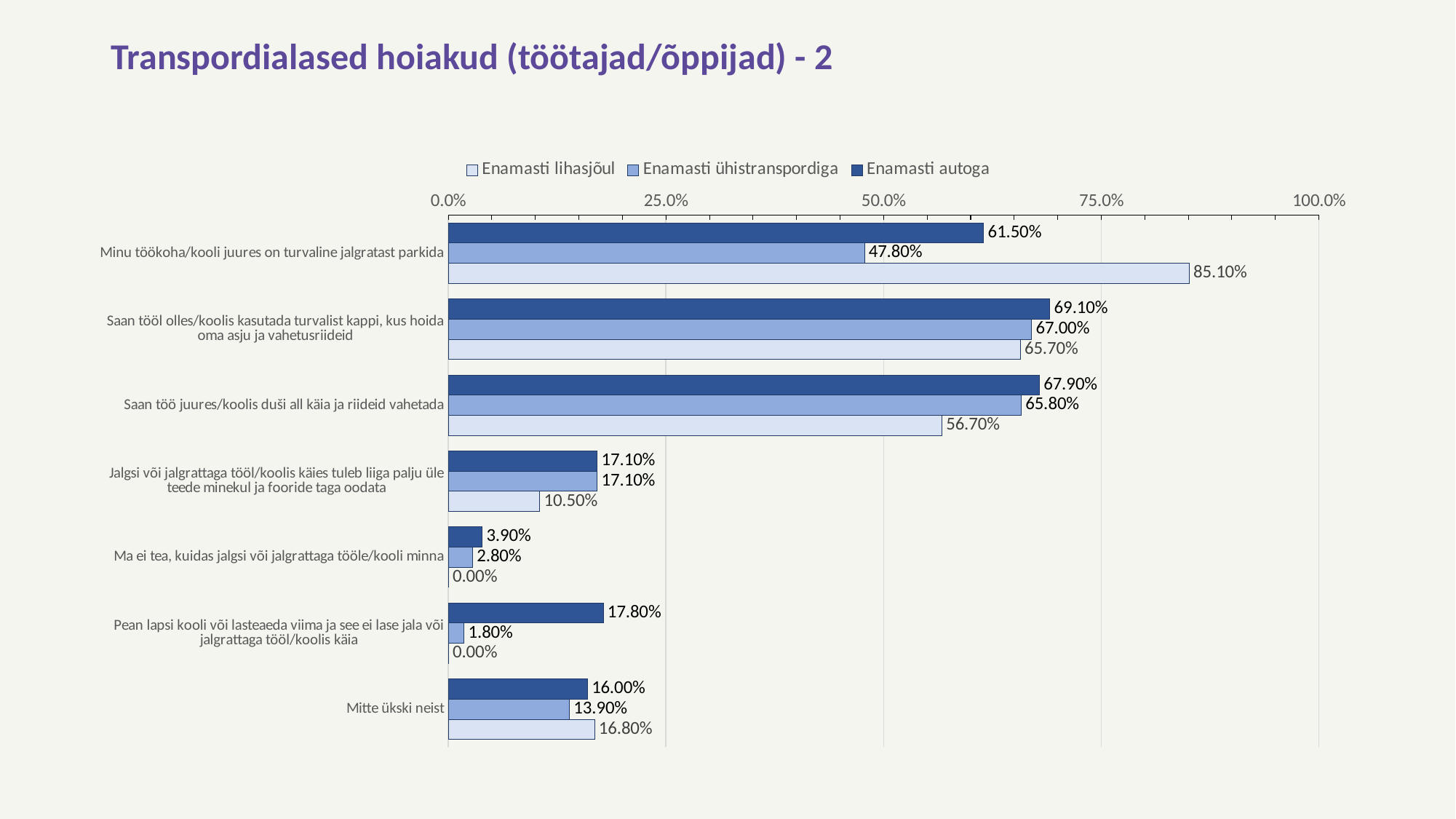
What is the value for 'Enamasti autoga' in the category 'Pean lapsi kooli või lasteaeda viima ja see ei lase jala või jalgrattaga tööl/koolis käia'? 17.80% How many series does the legend list? 3 Is the 'Enamasti autoga' value for 'Saan tööl olles/koolis kasutada turvalist kappi, kus hoida oma asju ja vahetusriideid' greater or less than 50.0%? greater Which category has the highest value for the 'Enamasti autoga' series? Saan tööl olles/koolis kasutada turvalist kappi, kus hoida oma asju ja vahetusriideid What is the value for 'Enamasti lihasjõul' in the category 'Minu töökoha/kooli juures on turvaline jalgratast parkida'? 85.10% What kind of chart is shown on the slide? bar chart What is the difference between the 'Enamasti lihasjõul' and 'Enamasti ühistranspordiga' values for 'Minu töökoha/kooli juures on turvaline jalgratast parkida'? 37.30% Which category has the lowest value for the 'Enamasti ühistranspordiga' series? Pean lapsi kooli või lasteaeda viima ja see ei lase jala või jalgrattaga tööl/koolis käia What is the value for 'Enamasti ühistranspordiga' in the category 'Mitte ükski neist'? 13.90% In the category 'Saan töö juures/koolis duši all käia ja riideid vahetada', which is larger: the 'Enamasti autoga' value or the 'Enamasti lihasjõul' value? Enamasti autoga What is the title of the slide? Transpordialased hoiakud (töötajad/õppijad) - 2 How many categories are shown on the chart? 7